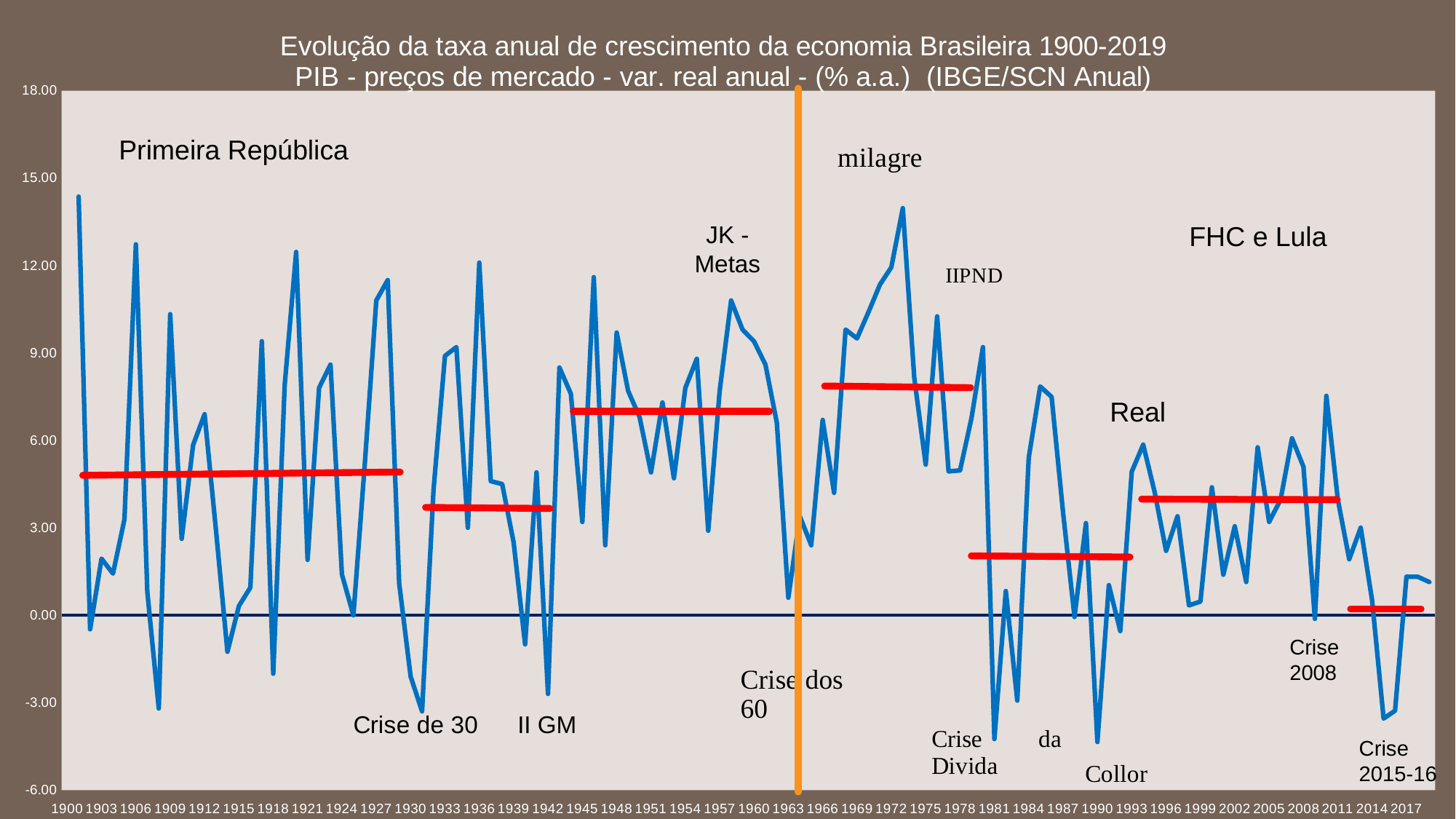
Is the value for 1981 greater or less than -3.00? less Is the value for 2017 greater or less than 3.00? less What is the title of the chart? Evolução da taxa anual de crescimento da economia Brasileira 1900-2019 PIB - preços de mercado - var. real anual - (% a.a.) (IBGE/SCN Anual) Is the value for 1990 greater or less than -3.00? less Do the values rise or fall from 2010 to 2016? fall Which period label is written above the red horizontal line covering roughly 1965 to 1979? milagre Which is larger, the value for 1973 or the value for 1990? 1973 What kind of chart is shown on the slide? line chart